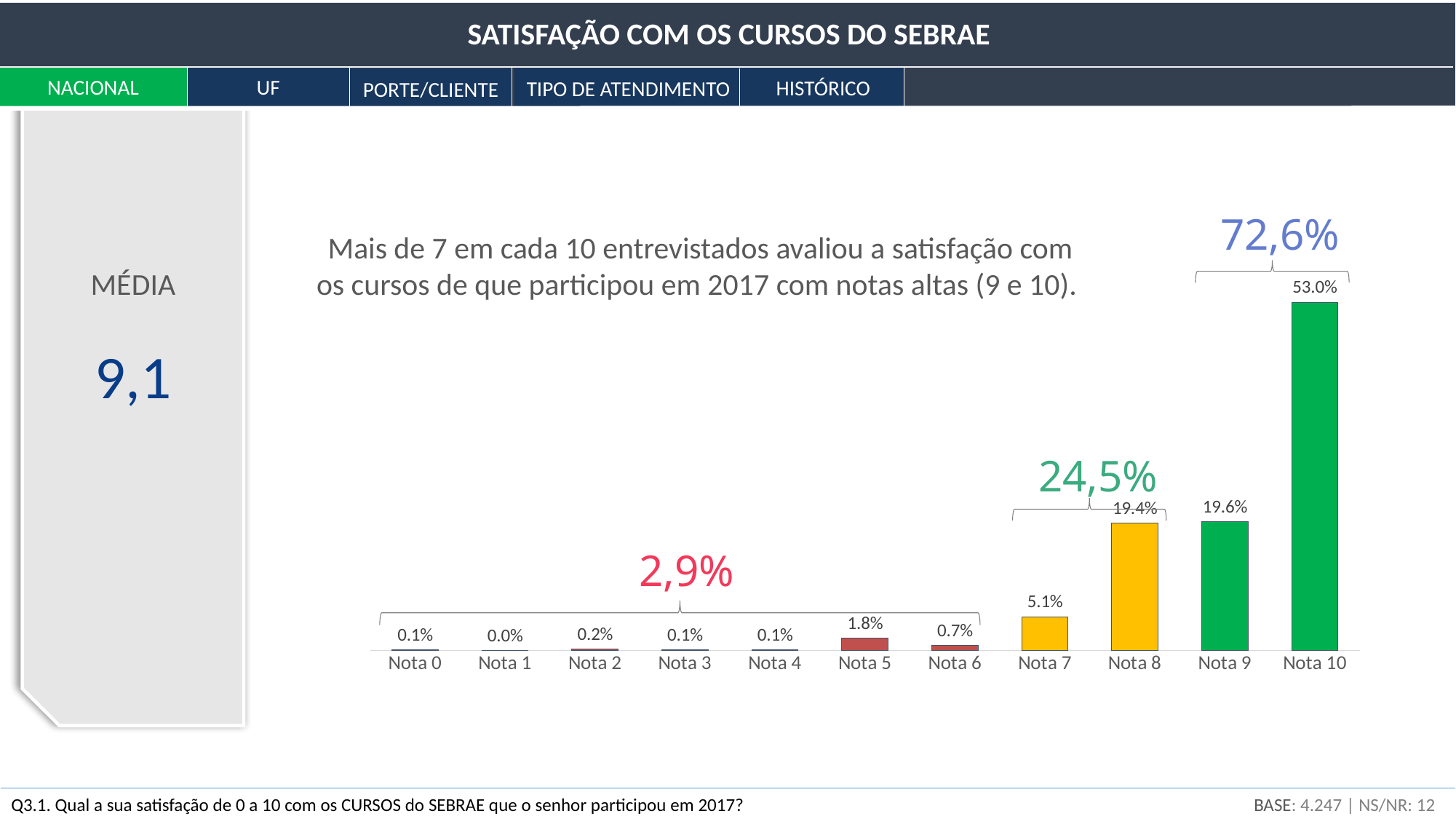
Which category has the highest value? Nota 10 What is the average (MÉDIA) shown on the left panel of the slide? 9,1 What is the value for Nota 8? 19.4% Which category has the lowest value? Nota 1 What is the value for Nota 7? 5.1% Which is larger, the value for Nota 7 or the value for Nota 6? Nota 7 What combined percentage is shown above the bracket grouping Nota 9 and Nota 10? 72,6% What is the value for Nota 5? 1.8% What is the value for Nota 10? 53.0% What is the difference between the values for Nota 10 and Nota 9? 33.4% How many categories are shown on the x axis? 11 What kind of chart is shown on the slide? bar chart